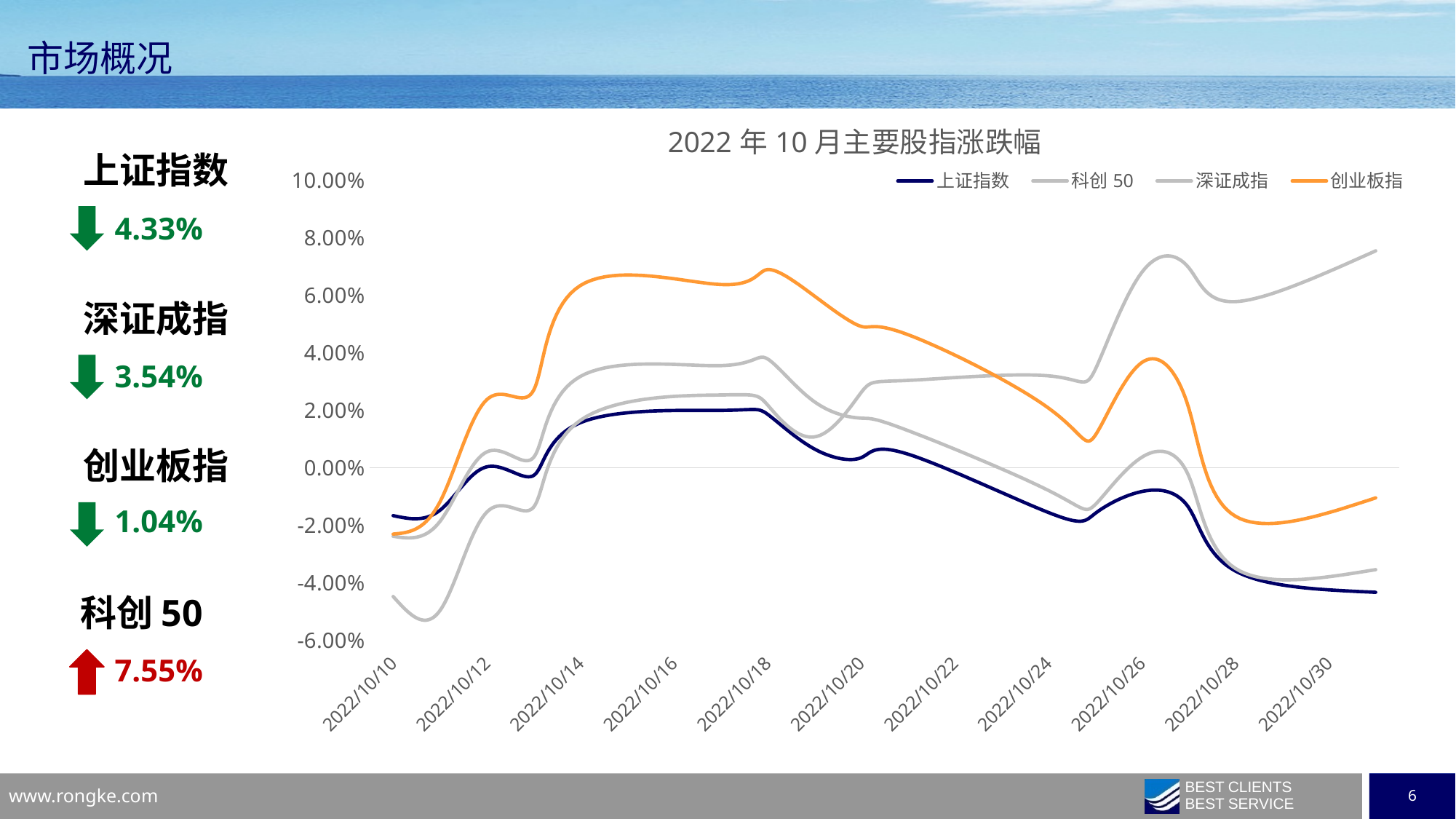
How many series does the chart legend list? 4 Does the 创业板指 line rise or fall between 2022/10/10 and 2022/10/14? rise What is the title of the chart? 2022 年 10 月主要股指涨跌幅 Is the value for 上证指数 at 2022/10/30 greater or less than -2.00%? less Is the value for 创业板指 at 2022/10/10 greater or less than 0.00%? less Does the 上证指数 line rise or fall between 2022/10/26 and 2022/10/30? fall Which series is drawn in orange in the chart? 创业板指 Is the value for 上证指数 at 2022/10/18 greater or less than 0.00%? greater At 2022/10/18, which is higher: 创业板指 or 上证指数? 创业板指 What kind of chart is shown on the slide? line chart